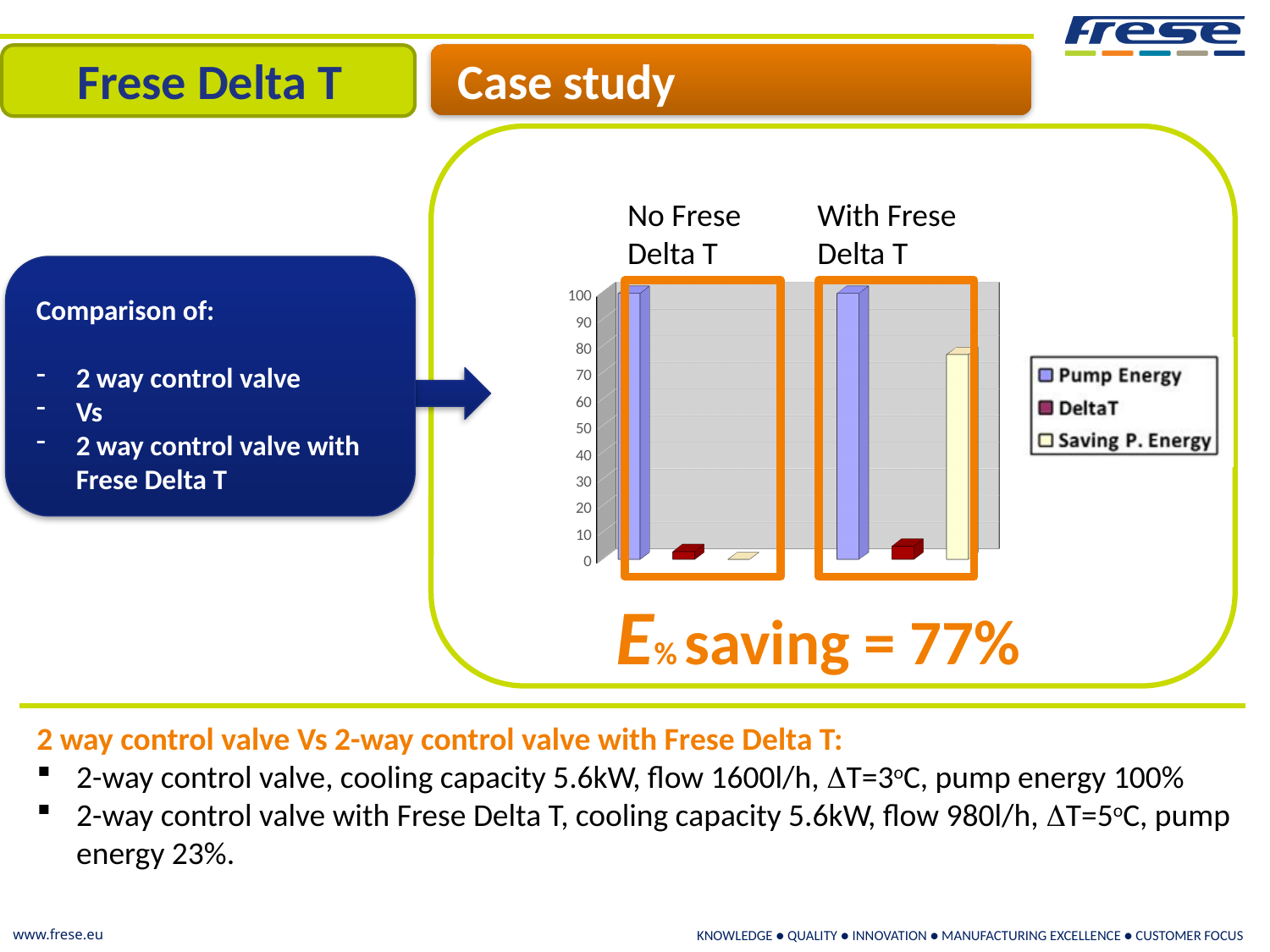
Is the DeltaT value for No Frese Delta T greater or less than 10? less Is the Saving P. Energy bar larger for No Frese Delta T or for With Frese Delta T? With Frese Delta T Is the Saving P. Energy value for With Frese Delta T greater or less than 80? less How many series does the chart legend list? 3 Which series has the lowest bar in the With Frese Delta T group? DeltaT What kind of chart is shown on the slide? bar chart Is the Pump Energy value for No Frese Delta T greater or less than 90? greater What are the two category groups labelled above the chart? No Frese Delta T and With Frese Delta T How many category groups are plotted on the chart? 2 Which series is shown in yellow in the chart legend? Saving P. Energy Which series has the highest bar in the No Frese Delta T group? Pump Energy